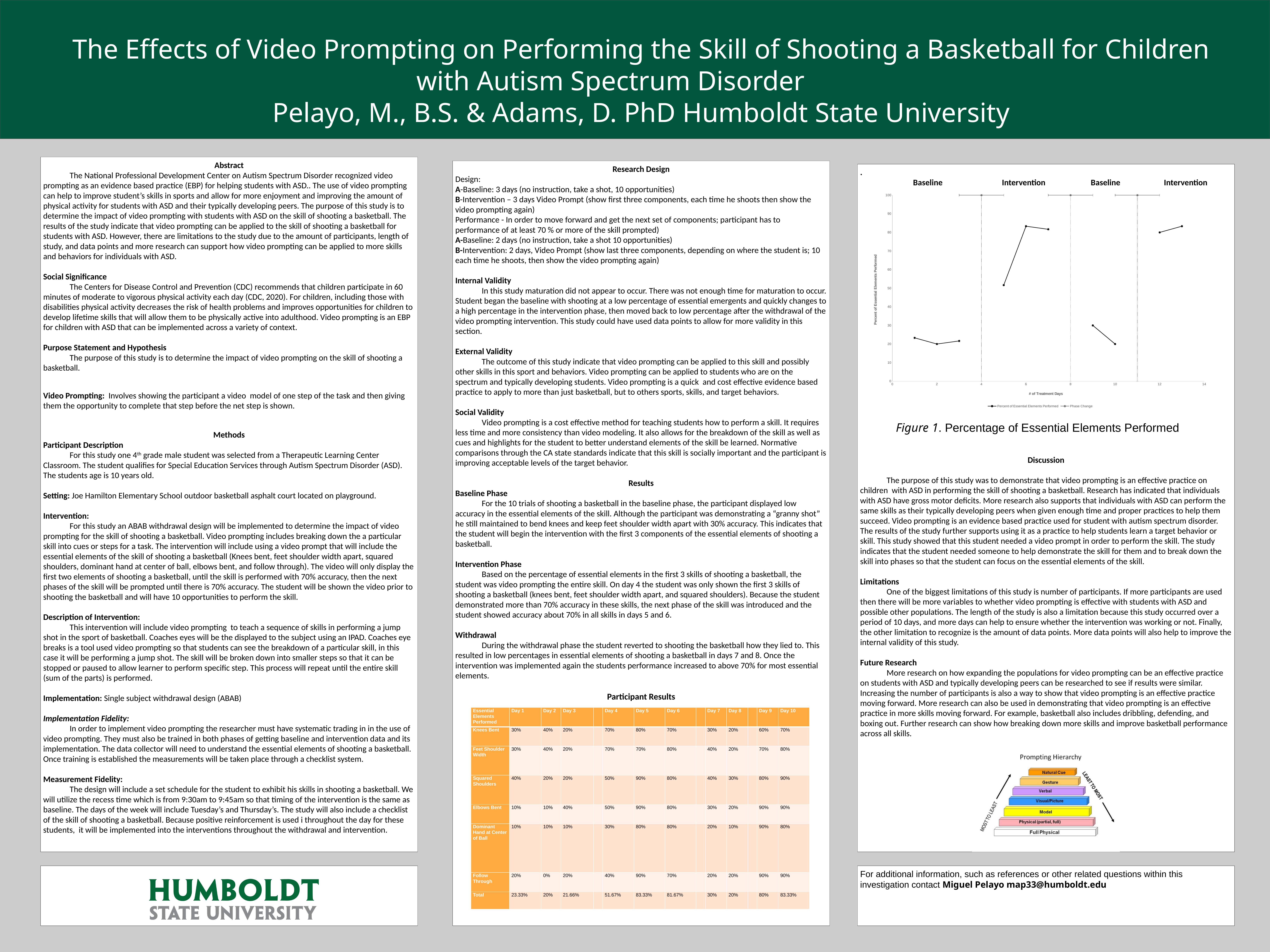
How many series does the legend of Figure 1 list? 2 In Figure 1, is the value for treatment day 6 greater or less than 70? greater What is the title of the vertical axis in Figure 1? Percent of Essential Elements Performed In Figure 1, is the value for treatment day 5 greater or less than 40? greater How many data points are plotted for Percent of Essential Elements Performed in Figure 1? 10 In Figure 1, is the value for treatment day 2 greater or less than 30? less In Figure 1, which has the larger value: treatment day 6 or treatment day 2? treatment day 6 In Figure 1, do the values rise or fall from treatment day 5 to treatment day 6 in the first Intervention phase? rise What is the title of the horizontal axis in Figure 1? # of Treatment Days What kind of chart is Figure 1 on the slide? line chart